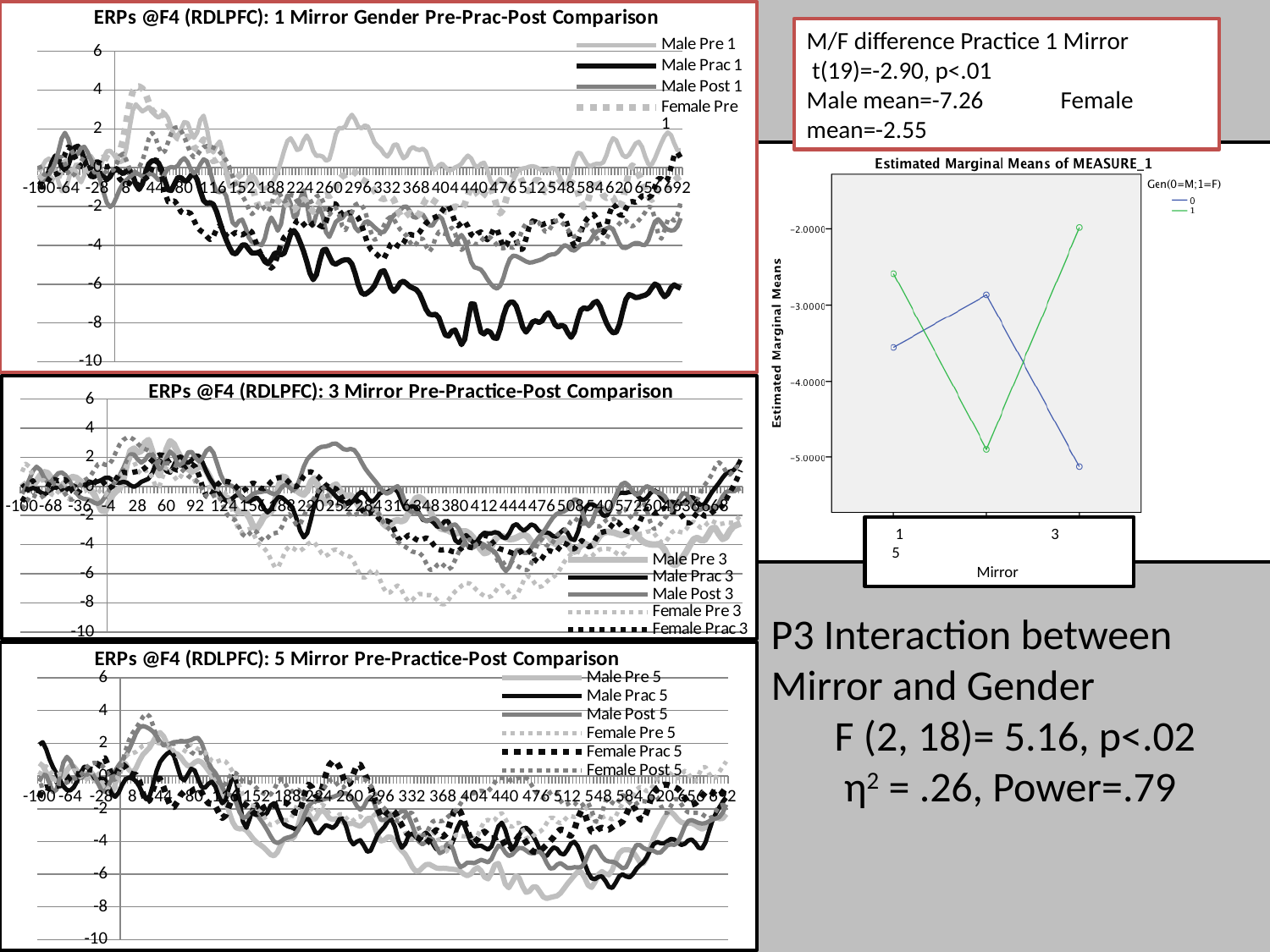
What is the title of the chart in the upper right with the blue and green lines? Estimated Marginal Means of MEASURE_1 In the "Estimated Marginal Means of MEASURE_1" chart, is the value of line 0 at Mirror 1 greater or less than -3.0000? less In the "Estimated Marginal Means of MEASURE_1" chart, is the value of line 1 at Mirror 3 greater or less than -4.0000? less In the bottom-left chart titled "ERPs @F4 (RDLPFC): 5 Mirror Pre-Practice-Post Comparison", how many series does the legend list? 6 In the "Estimated Marginal Means of MEASURE_1" chart, does line 0 rise or fall from Mirror 3 to Mirror 5? Fall What kind of chart is the top-left chart titled "ERPs @F4 (RDLPFC): 1 Mirror Gender Pre-Prac-Post Comparison"? Line chart In the "Estimated Marginal Means of MEASURE_1" chart, which gender line (0 or 1) is higher at Mirror 5? 1 In the top-left chart titled "ERPs @F4 (RDLPFC): 1 Mirror Gender Pre-Prac-Post Comparison", does the Male Prac 1 line drop below -8 at any point? Yes In the "Estimated Marginal Means of MEASURE_1" chart, which gender line (0 or 1) is higher at Mirror 3? 0 In the "Estimated Marginal Means of MEASURE_1" chart, how many Mirror categories are shown on the x axis? 3 In the middle-left chart titled "ERPs @F4 (RDLPFC): 3 Mirror Pre-Practice-Post Comparison", what is the lowest value shown on the y axis? -10 In the "Estimated Marginal Means of MEASURE_1" chart, how many lines does the legend list? 2